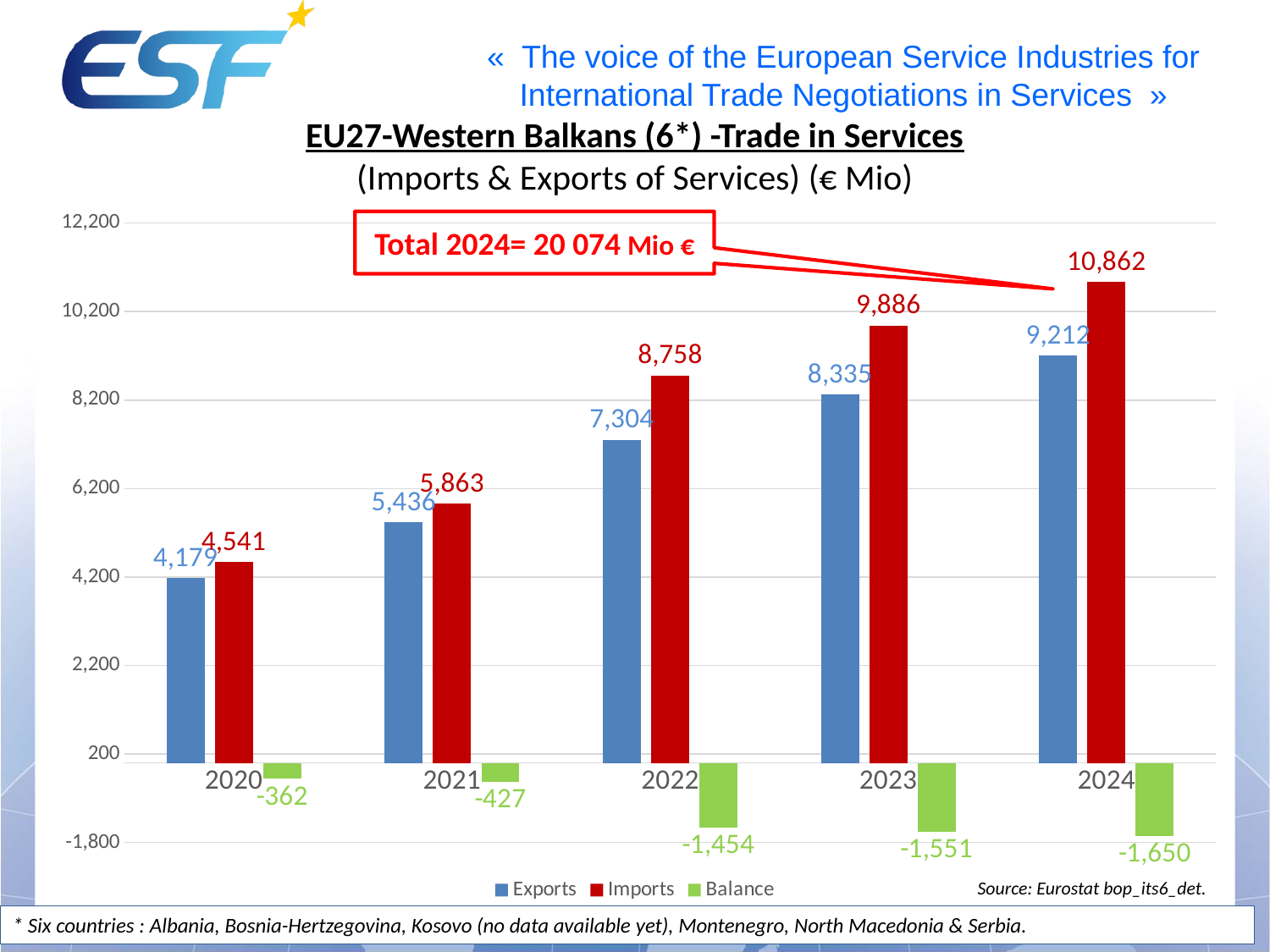
In which year are Imports highest? 2024 Do Imports rise or fall from 2020 to 2024? Rise How many series does the legend list? 3 Which is larger in 2020, Exports or Imports? Imports Is the value for Exports in 2024 greater or less than 8,200? greater What is the value of Imports in 2024? 10,862 In which year are Exports lowest? 2020 What is the difference between Imports and Exports in 2023? 1,551 What is the Balance value for 2021? -427 How many years are shown on the x axis? 5 What kind of chart is shown on the slide? Bar chart What is the value of Exports in 2022? 7,304